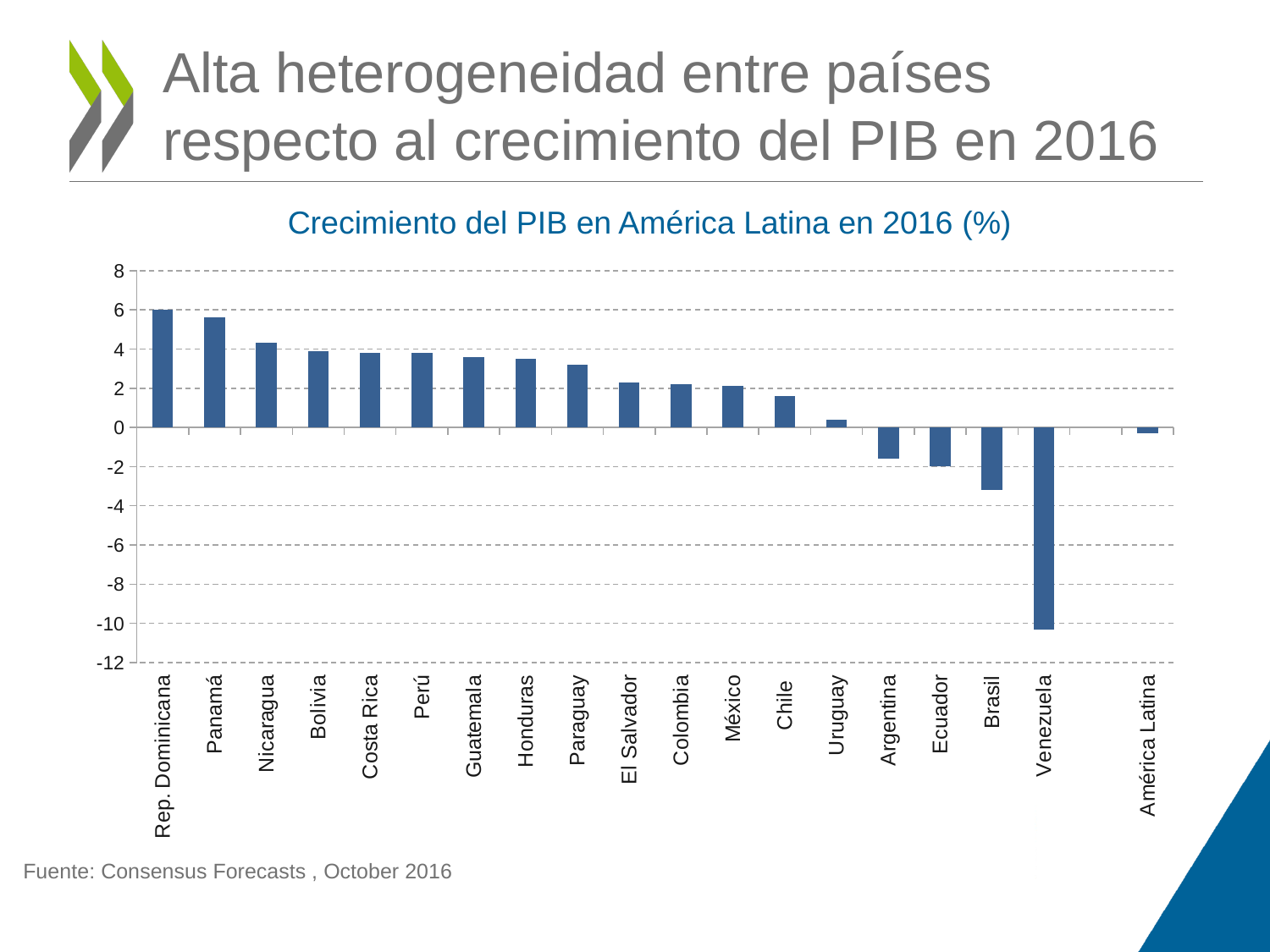
How many categories are plotted on the x axis of the chart? 19 What is the title of the chart? Crecimiento del PIB en América Latina en 2016 (%) Is the value for Panamá greater or less than 4? greater Which category has the lowest value in the chart? Venezuela What kind of chart is shown on the slide? Bar chart Is the value for Brasil greater or less than -2? less Is the value for Argentina greater or less than -4? greater Which has the larger value, Panamá or Nicaragua? Panamá Which category has the highest value in the chart? Rep. Dominicana Do the values generally rise or fall moving from left to right along the x axis? Fall